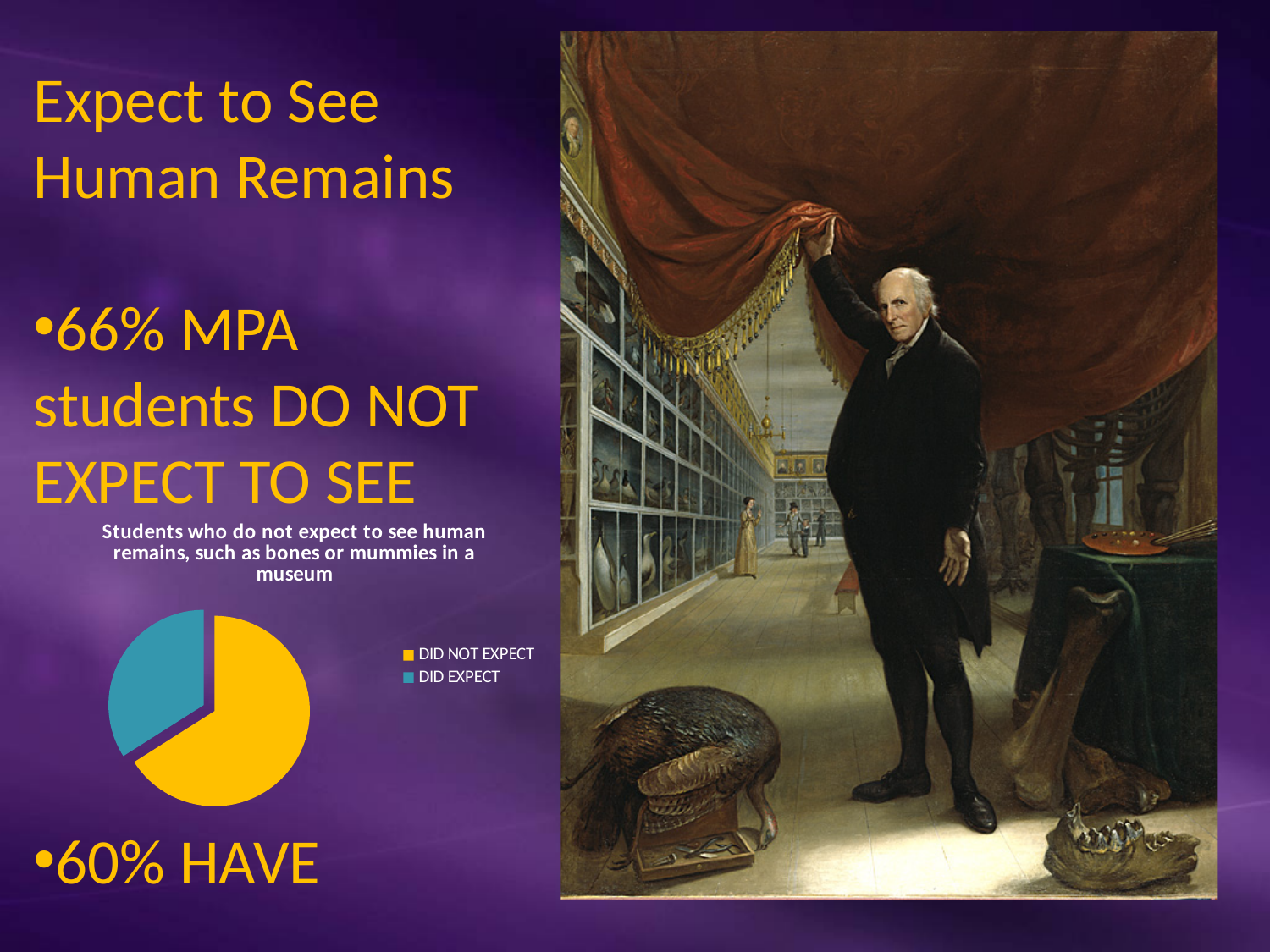
How many entries does the pie chart's legend list? 2 Which slice of the pie chart is larger, DID NOT EXPECT or DID EXPECT? DID NOT EXPECT What colour is the DID NOT EXPECT slice in the pie chart? yellow Which category has the smallest slice in the pie chart? DID EXPECT What kind of chart is shown on the slide? pie chart Is the DID NOT EXPECT slice of the pie chart greater or less than half of the pie? greater What is the title of the pie chart? Students who do not expect to see human remains, such as bones or mummies in a museum Is the DID EXPECT slice of the pie chart greater or less than half of the pie? less Which category has the largest slice in the pie chart? DID NOT EXPECT How many slices does the pie chart have? 2